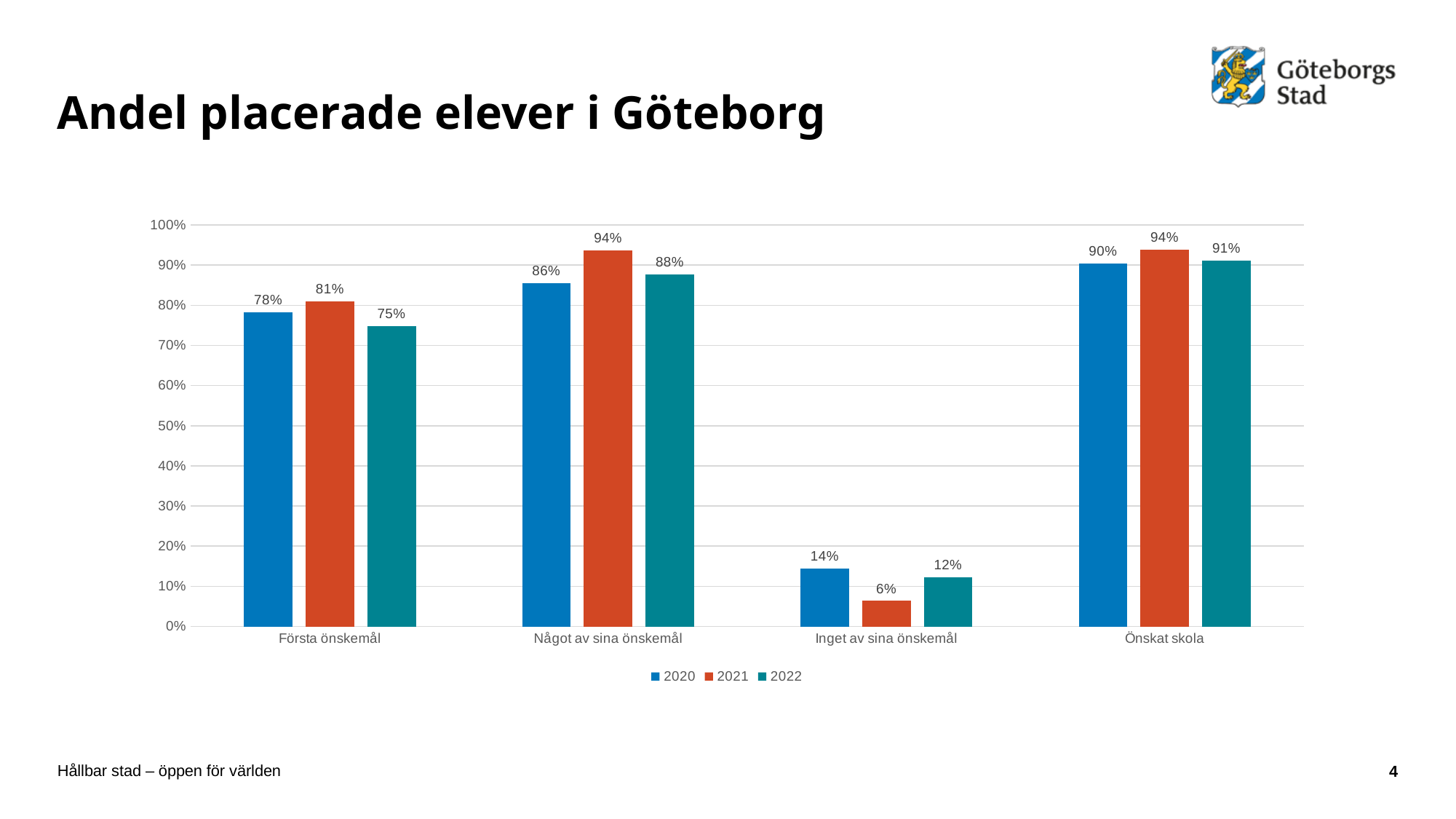
How many series does the legend list? 3 What is the value for 2021 in the Första önskemål category? 81% How many categories are shown on the x axis? 4 What is the difference between the 2022 and 2020 values in the Första önskemål category? 3% Which is larger: the 2020 value for Första önskemål or the 2020 value for Något av sina önskemål? Något av sina önskemål What kind of chart is shown on the slide? Bar chart What is the title of the slide? Andel placerade elever i Göteborg What is the value for 2020 in the Önskat skola category? 90% Which category has the lowest value for the 2021 series? Inget av sina önskemål What is the difference between the 2020 and 2021 values in the Inget av sina önskemål category? 8% Which year has the highest value in the Något av sina önskemål category? 2021 What is the value for 2022 in the Inget av sina önskemål category? 12%